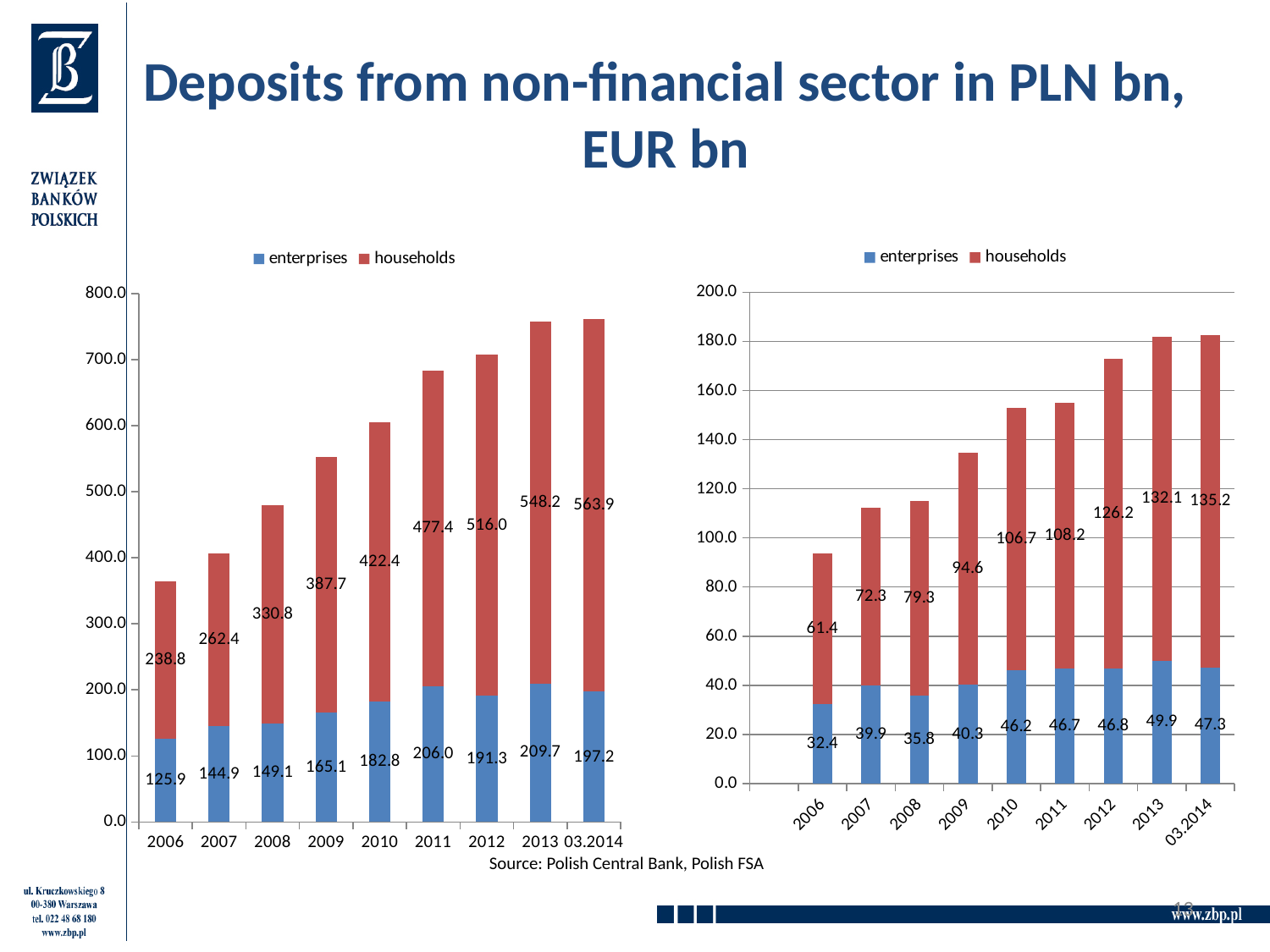
In the right chart (EUR bn), which year has the lowest value for enterprises? 2006 In the right chart (EUR bn), which is larger: the enterprises value for 2013 or for 2011? 2013 What kind of chart is the left chart (PLN bn)? Stacked bar chart In the right chart (EUR bn), what is the value for enterprises in 2009? 40.3 In the left chart (PLN bn), what is the total of the stacked bar for 2006? 364.7 In the left chart (PLN bn), what is the value for households in 2010? 422.4 How many periods are shown on the x axis of the left chart (PLN bn)? 9 In the right chart (EUR bn), do the households values rise or fall from 2006 to 03.2014? Rise In the right chart (EUR bn), what is the total of the stacked bar for 03.2014? 182.5 How many series does the legend of the right chart (EUR bn) list? 2 In the left chart (PLN bn), which year has the highest value for households? 03.2014 In the left chart (PLN bn), what is the difference between the households values for 2013 and 2012? 32.2